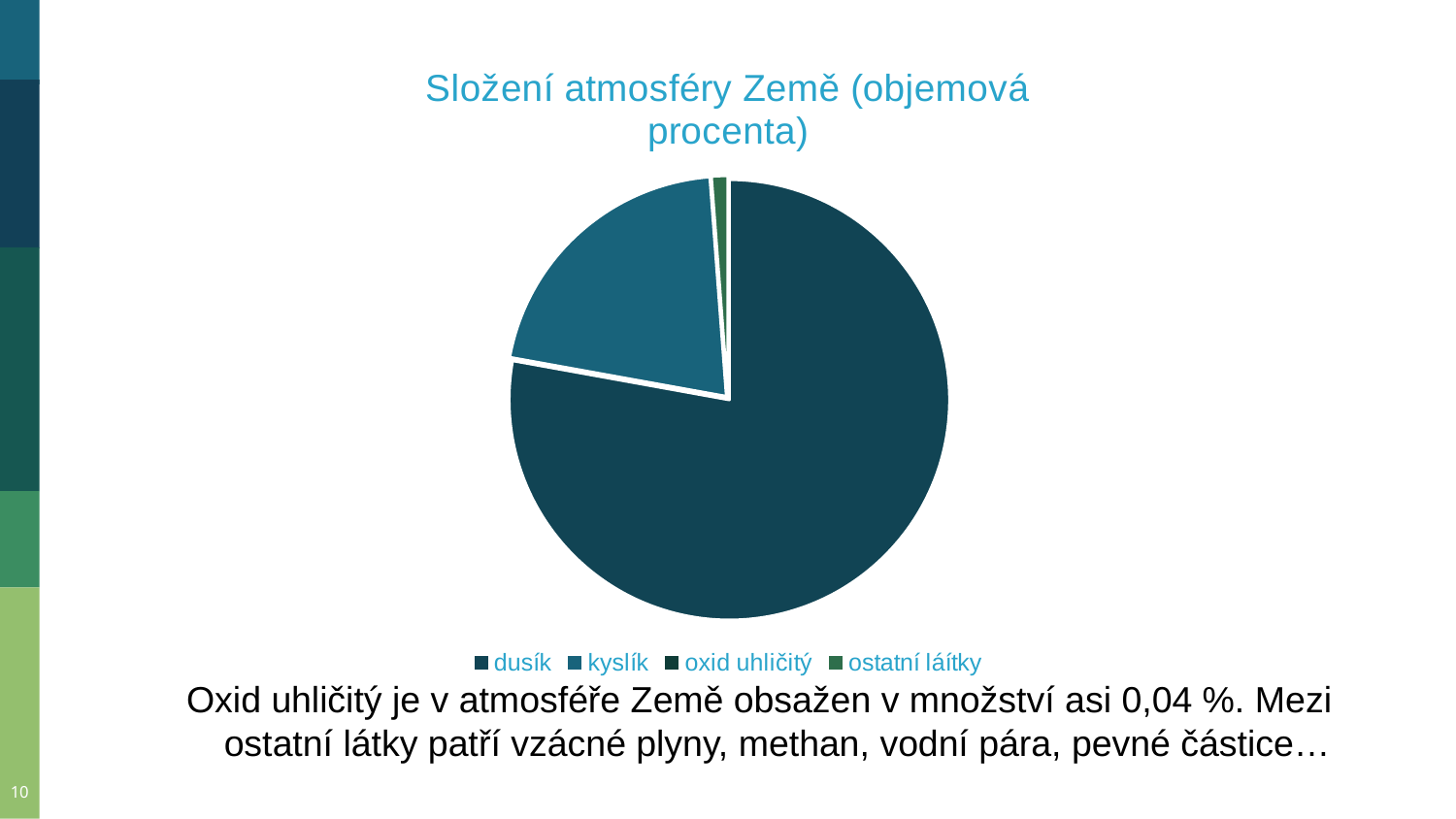
How many entries does the chart legend list? 4 Which slice is larger, dusík or kyslík? dusík What kind of chart is shown on the slide? pie chart Which slice is larger, kyslík or ostatní láítky? kyslík Which category is listed first in the legend? dusík Where is the legend placed relative to the pie chart? below the chart Does the kyslík slice take up more or less than half of the pie? less Which category has the largest slice of the pie? dusík What is the title of the chart? Složení atmosféry Země (objemová procenta) Does the dusík slice take up more or less than half of the pie? more